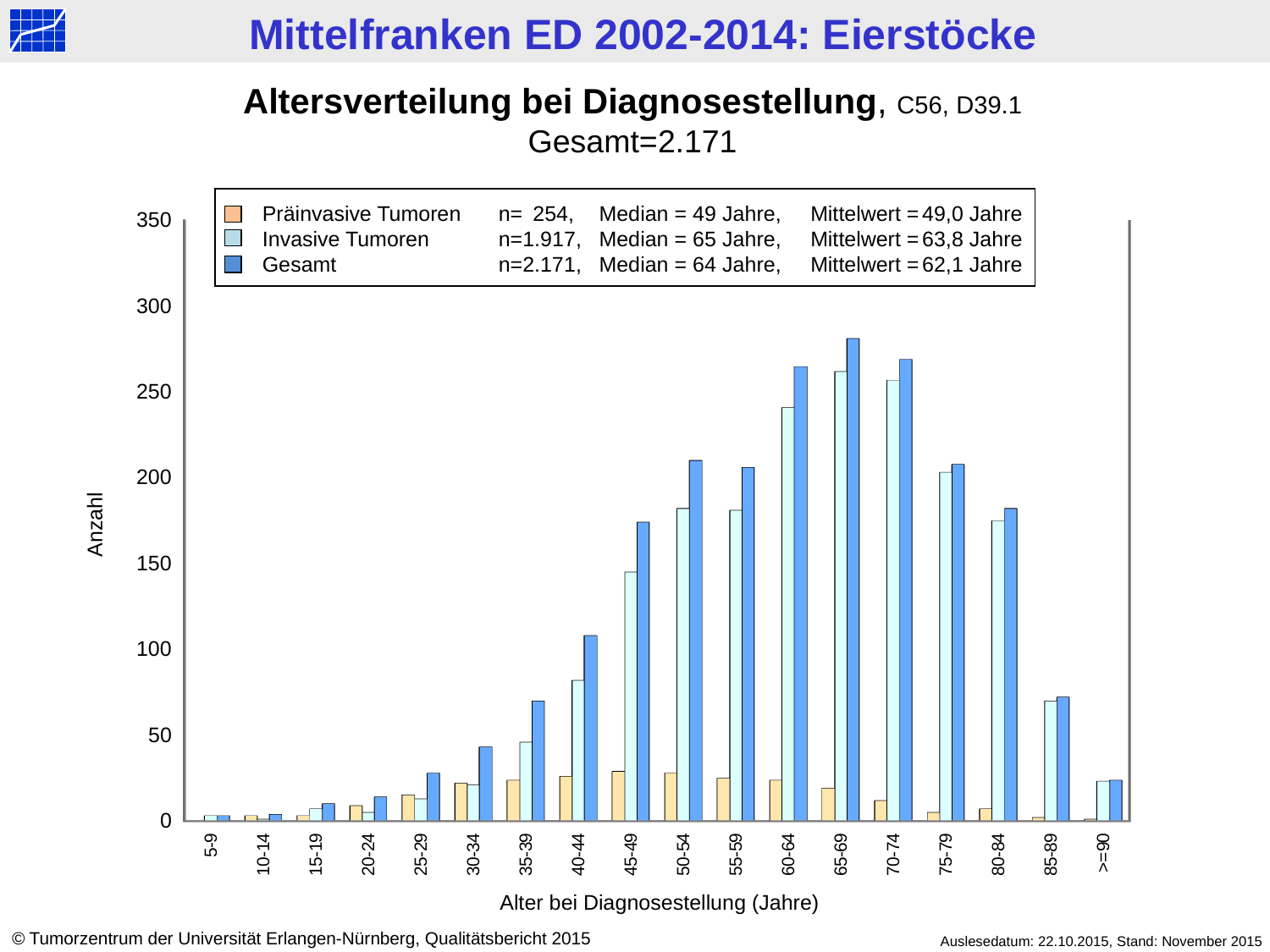
How many age categories are shown on the x axis? 18 What kind of chart is shown on the slide? bar chart Which is larger for the 45-49 age group: Präinvasive Tumoren or Invasive Tumoren? Invasive Tumoren Is the Gesamt value for the 50-54 age group greater or less than 200? greater How many series does the legend list? 3 Do the Gesamt values rise or fall from the 5-9 age group to the 65-69 age group? rise According to the legend, what is the median age for Präinvasive Tumoren? 49 Jahre Is the Invasive Tumoren value for the 40-44 age group greater or less than 100? less Which is larger for the 80-84 age group: the Gesamt value or the Gesamt value for 85-89? 80-84 Is the Gesamt value for the 65-69 age group greater or less than 250? greater According to the legend, what is the n value for Invasive Tumoren? n=1.917 Which age category has the highest value for the Gesamt series? 65-69